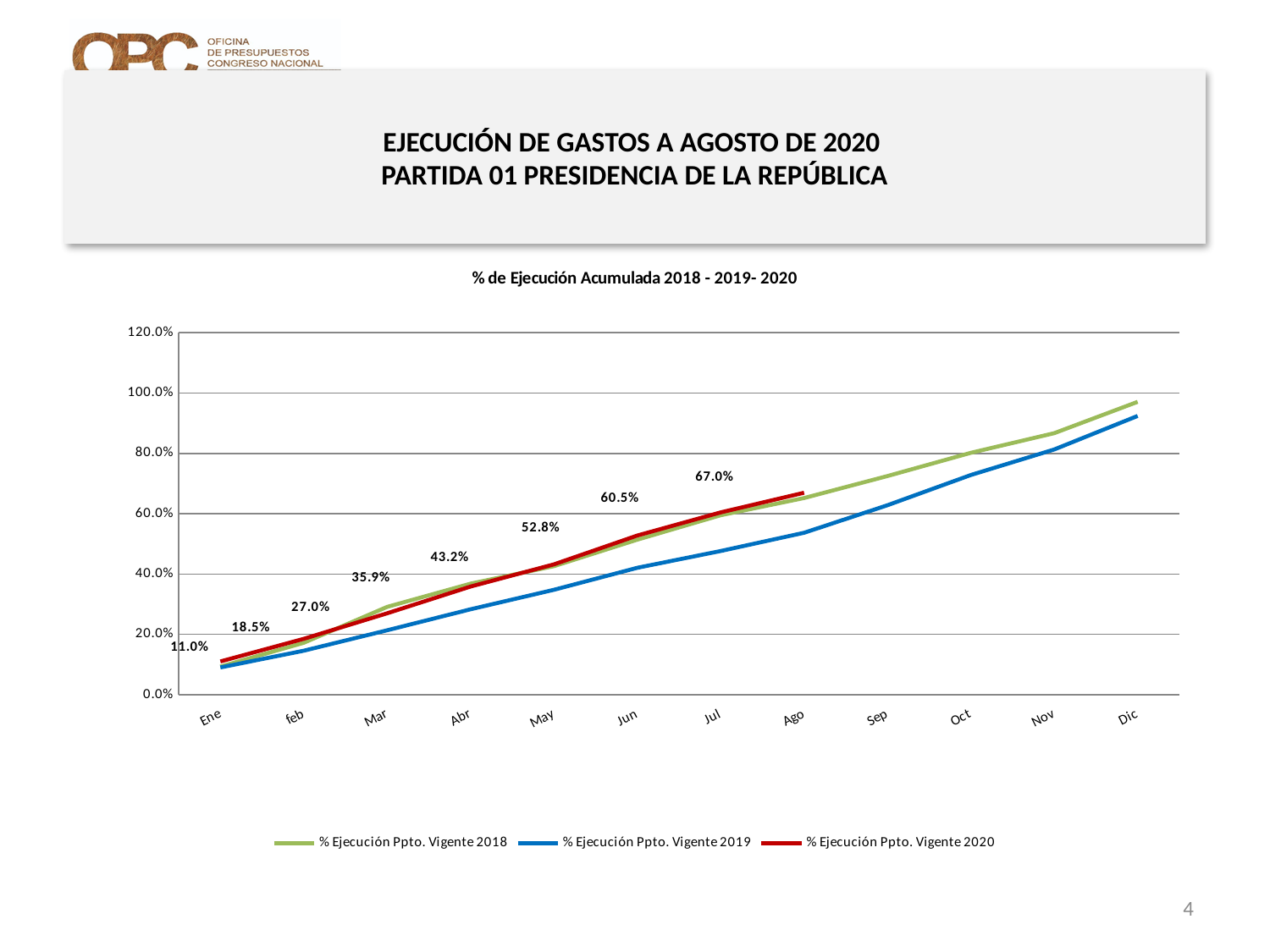
What type of chart is shown on the slide? line chart What is the difference between the 2020 values for Jun and May? 9.6% What is the value of % Ejecución Ppto. Vigente 2020 in Ago? 67.0% How many months are shown on the x axis? 12 What is the title of the chart? % de Ejecución Acumulada 2018 - 2019- 2020 Which series has the higher value in Dic, % Ejecución Ppto. Vigente 2018 or % Ejecución Ppto. Vigente 2019? % Ejecución Ppto. Vigente 2018 Does the % Ejecución Ppto. Vigente 2020 line rise or fall from Ene to Ago? rise Is the value for % Ejecución Ppto. Vigente 2019 in Ago greater or less than 60.0%? less What is the difference between the 2020 values for Ago and Jul? 6.5% What is the value of % Ejecución Ppto. Vigente 2020 in Abr? 35.9% How many series does the legend list? 3 What is the value of % Ejecución Ppto. Vigente 2020 in Ene? 11.0%